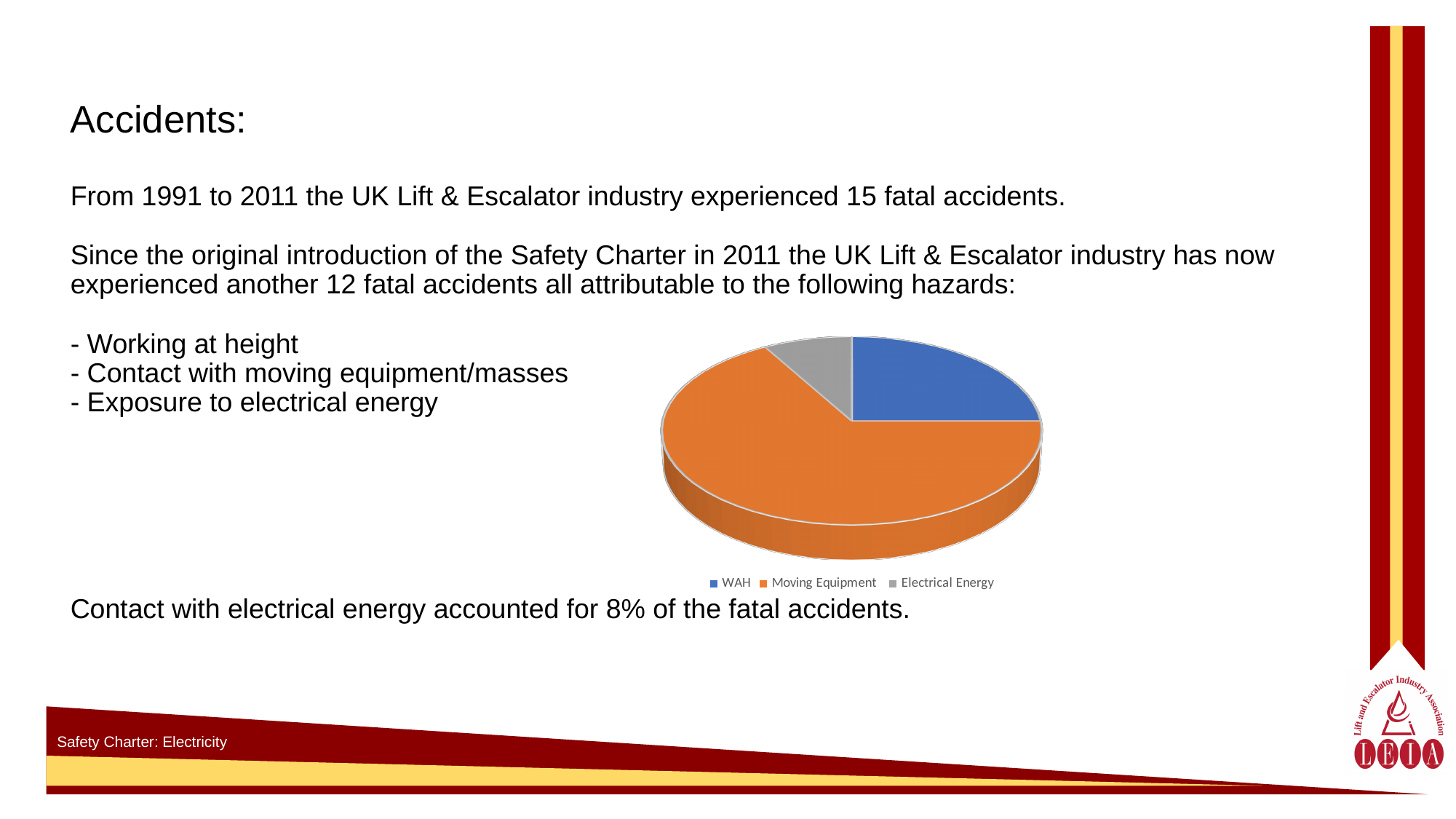
What kind of chart is shown on the slide? Pie chart What are the three legend entries of the pie chart? WAH, Moving Equipment, Electrical Energy How many slices does the pie chart have? 3 Which category has the largest slice of the pie chart? Moving Equipment According to the slide, what share of the fatal accidents did Electrical Energy account for? 8% How many entries does the pie chart's legend list? 3 Which slice is larger in the pie chart, Moving Equipment or WAH? Moving Equipment What colour is the WAH slice in the pie chart? Blue Which slice is larger in the pie chart, WAH or Electrical Energy? WAH Which category has the smallest slice of the pie chart? Electrical Energy